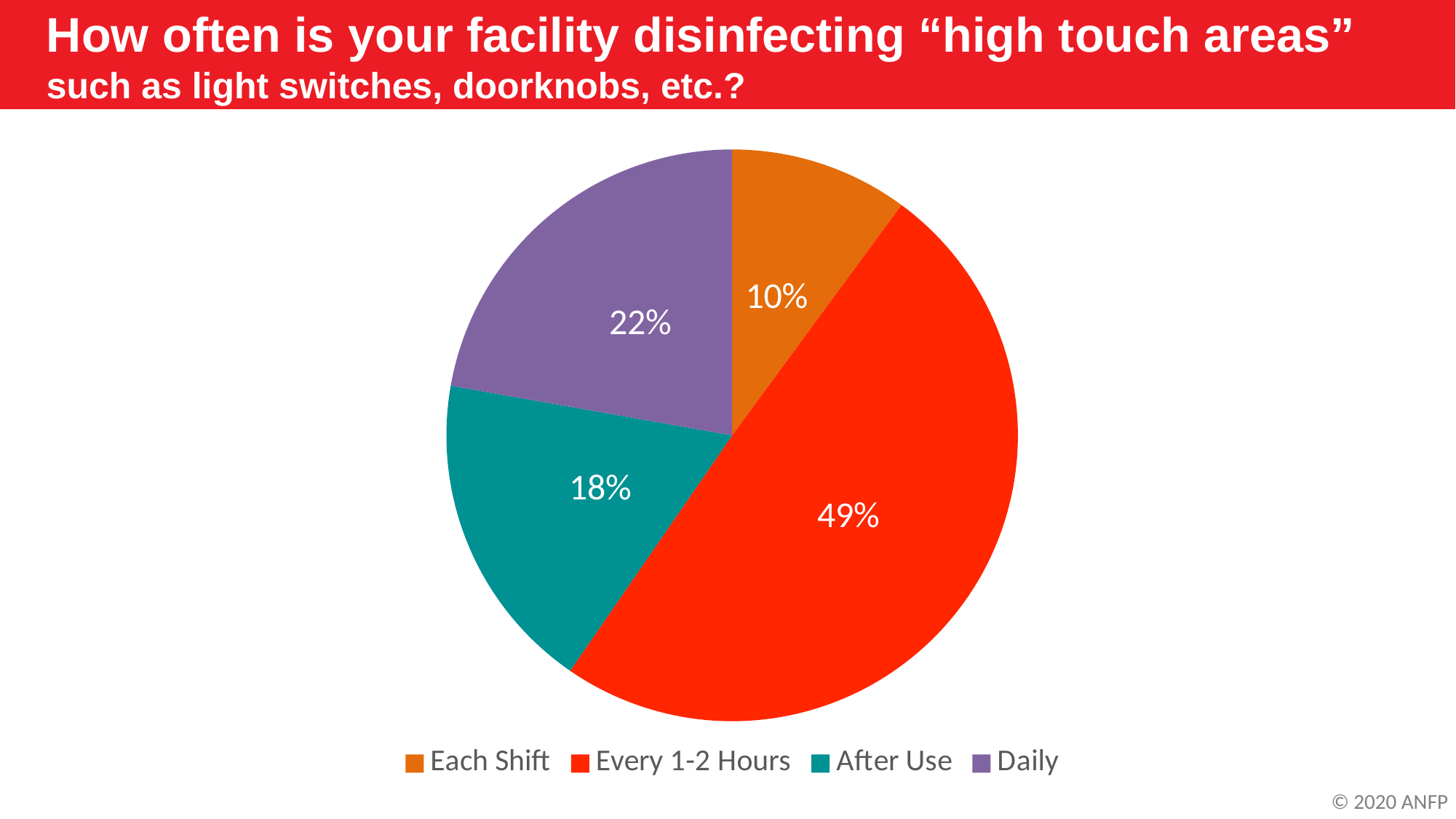
What percentage of facilities disinfect high touch areas every 1-2 hours? 49% What percentage of facilities disinfect high touch areas daily? 22% What is the difference in percentage points between the Every 1-2 Hours slice and the Daily slice? 27 Which response has the largest share of the pie? Every 1-2 Hours How many slices does the pie chart have? 4 What colour is the Every 1-2 Hours slice? Red What kind of chart is shown on the slide? Pie chart What percentage of facilities disinfect high touch areas each shift? 10% What is the combined share of the After Use and Daily slices? 40% What percentage of facilities disinfect high touch areas after use? 18% Which is larger, the Daily slice or the After Use slice? Daily Which response has the smallest share of the pie? Each Shift